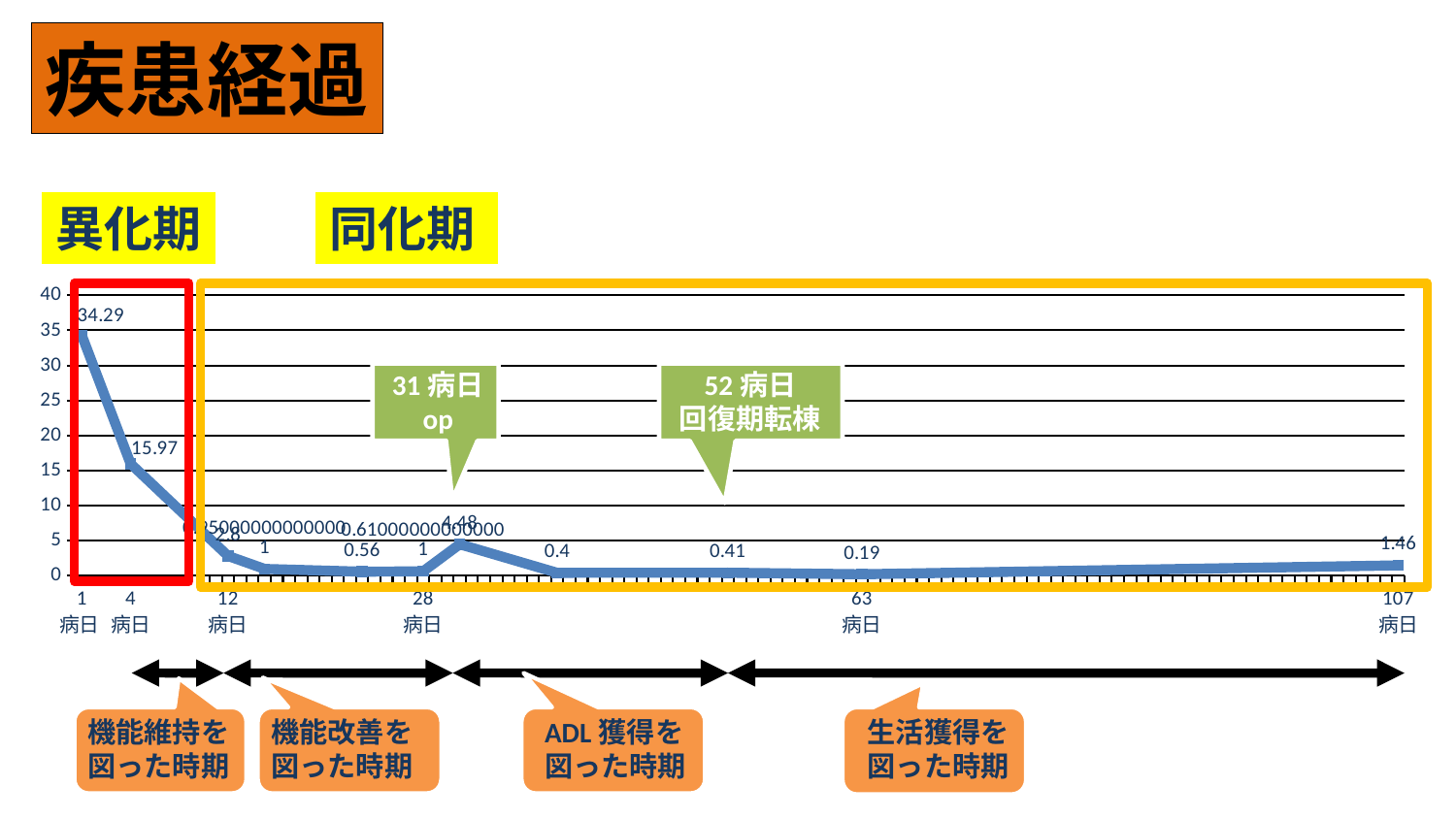
At which hospital day is the plotted value highest? 1病日 What is the value plotted at 107病日? 1.46 According to the callout on the chart, on which hospital day was the op performed? 31病日 Is the value at 12病日 greater or less than 5? less Which is larger, the value at 1病日 or the value at 4病日? 1病日 What is the highest value shown on the vertical axis? 40 Do the values generally rise or fall from 1病日 to 63病日? fall What kind of chart is shown on the slide? line chart Is the value at 63病日 greater or less than 5? less What is the value plotted at 1病日? 34.29 What is the difference between the values at 1病日 and 4病日? 18.32 What is the value plotted at 4病日? 15.97